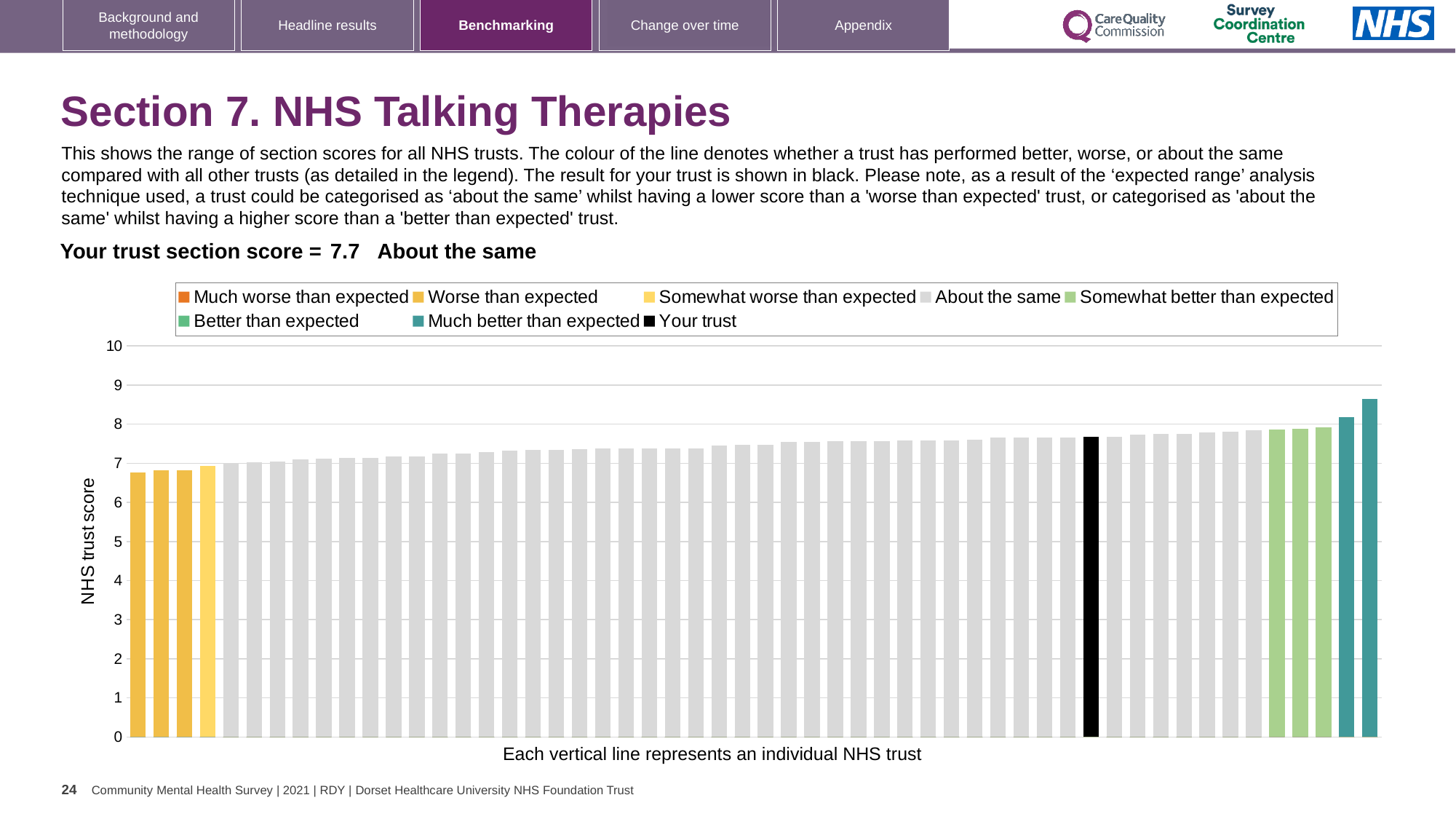
Do the bar values rise or fall from left to right across the chart? rise Which is larger, the leftmost bar or the rightmost bar? the rightmost bar What kind of chart is shown on the slide? bar chart How many entries does the chart legend list? 8 Is the value of the tallest bar in the chart greater or less than 8? greater What is the trust section score shown on the slide? 7.7 How many bars are coloured as 'Worse than expected'? 3 Which legend category does the tallest bar belong to? Much better than expected Is the value of the shortest bar in the chart greater or less than 7? less How many bars are coloured as 'Much better than expected'? 2 Is the value of the black 'Your trust' bar greater or less than 7? greater Which performance category is the trust's section score labelled as? About the same